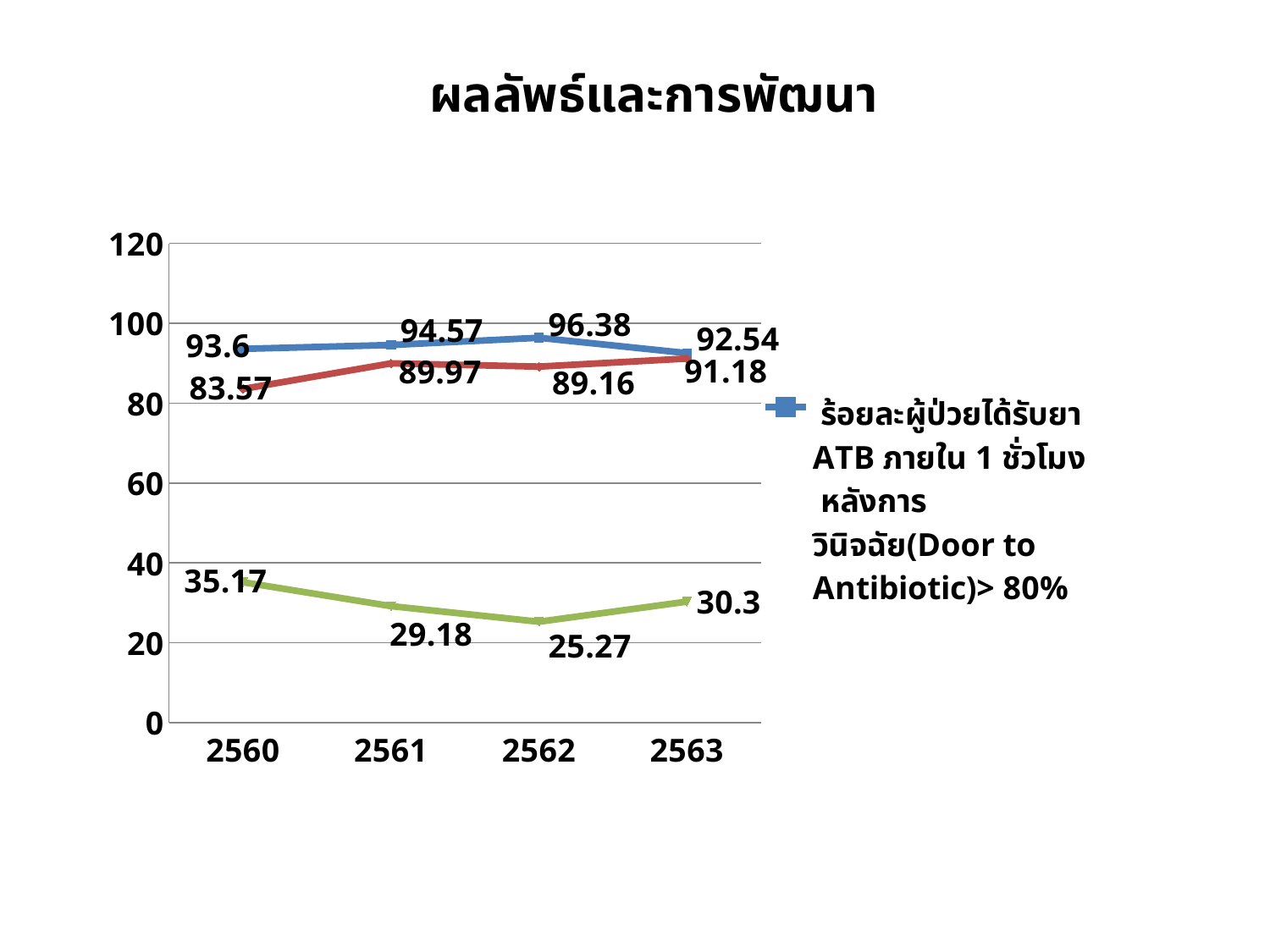
How many years are shown on the x axis of the chart? 4 In which year does the green line have its lowest value? 2562 What is the value of the red line in 2563? 91.18 Which is larger in 2561: the blue line's value or the red line's value? the blue line (94.57) What is the value of the blue line in 2560? 93.6 In which year does the blue line reach its highest value? 2562 What is the difference between the blue line's value in 2562 and its value in 2563? 3.84 What kind of chart is shown on the slide? line chart Does the red line rise or fall from 2560 to 2561? rise What is the value of the blue line (ร้อยละผู้ป่วยได้รับยา ATB ภายใน 1 ชั่วโมง หลังการวินิจฉัย) in 2562? 96.38 What is the title of the slide? ผลลัพธ์และการพัฒนา What is the value of the green line in 2562? 25.27